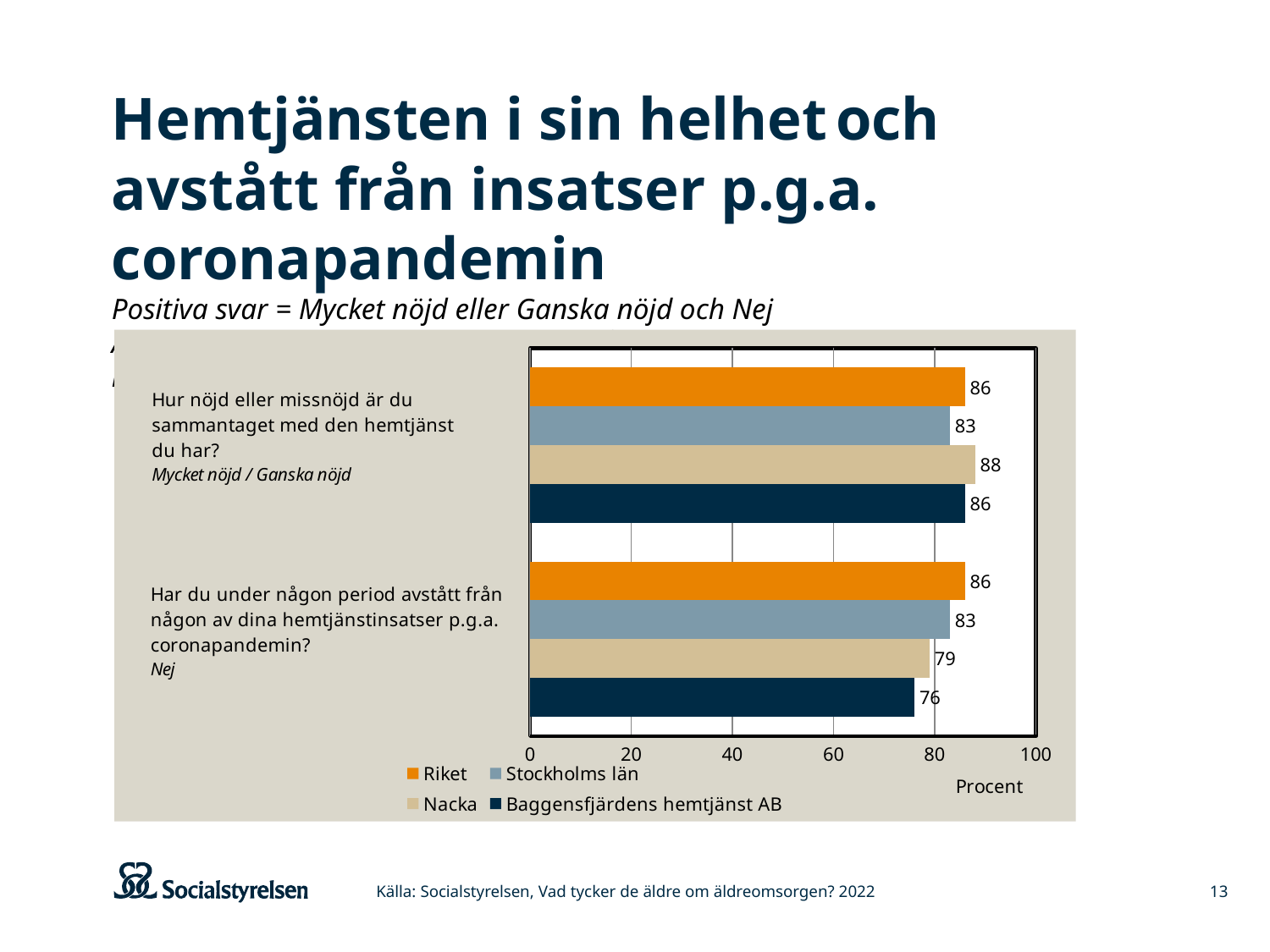
Which series has the highest value on the question "Hur nöjd eller missnöjd är du sammantaget med den hemtjänst du har?"? Nacka What is the label on the horizontal axis of the chart? Procent What is the value for Nacka on the question "Hur nöjd eller missnöjd är du sammantaget med den hemtjänst du har?"? 88 What is the value for Stockholms län on the question "Hur nöjd eller missnöjd är du sammantaget med den hemtjänst du har?"? 83 Is the value for Nacka on the question "Har du under någon period avstått från någon av dina hemtjänstinsatser p.g.a. coronapandemin?" greater or less than 80? less How many series does the legend list? 4 What is the value for Baggensfjärdens hemtjänst AB on the question "Har du under någon period avstått från någon av dina hemtjänstinsatser p.g.a. coronapandemin?"? 76 Which series has the lowest value on the question "Har du under någon period avstått från någon av dina hemtjänstinsatser p.g.a. coronapandemin?"? Baggensfjärdens hemtjänst AB Which is larger on the question "Har du under någon period avstått från någon av dina hemtjänstinsatser p.g.a. coronapandemin?": the value for Stockholms län or the value for Nacka? Stockholms län What kind of chart is shown on the slide? bar chart How many question categories are shown in the chart? 2 What is the difference between the Riket value and the Baggensfjärdens hemtjänst AB value on the question "Har du under någon period avstått från någon av dina hemtjänstinsatser p.g.a. coronapandemin?"? 10